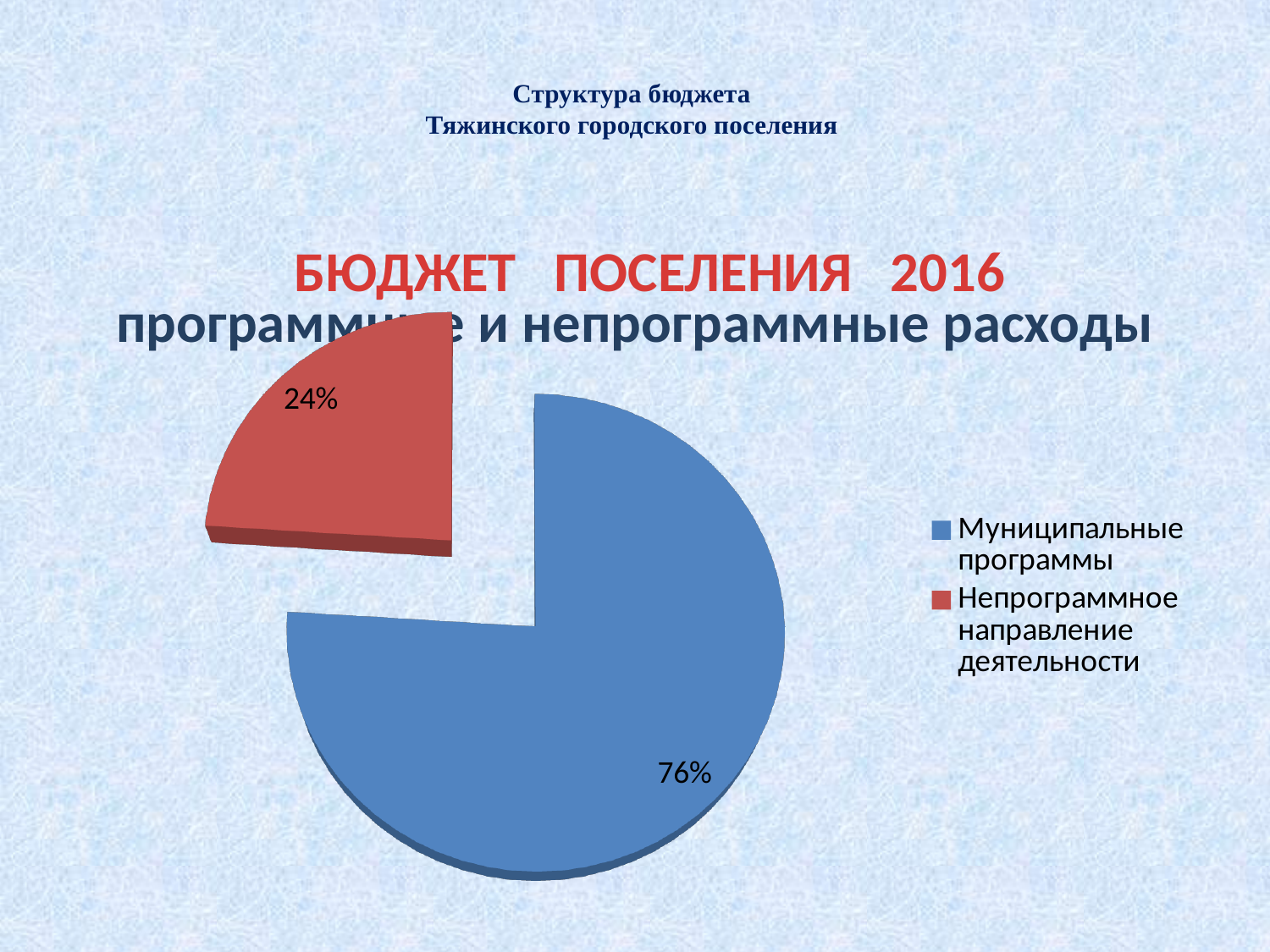
Which is larger: the slice for "Муниципальные программы" or the slice for "Непрограммное направление деятельности"? Муниципальные программы What is the difference in percentage points between the "Муниципальные программы" slice and the "Непрограммное направление деятельности" slice? 52 Which category has the largest slice of the pie? Муниципальные программы What share of the pie does "Непрограммное направление деятельности" have? 24% What kind of chart is shown on the slide? pie chart How many slices does the pie chart have? 2 How many entries does the legend list? 2 What colour is the slice for "Муниципальные программы"? blue What colour is the slice for "Непрограммное направление деятельности"? red Which category has the smallest slice of the pie? Непрограммное направление деятельности What share of the pie does "Муниципальные программы" have? 76%